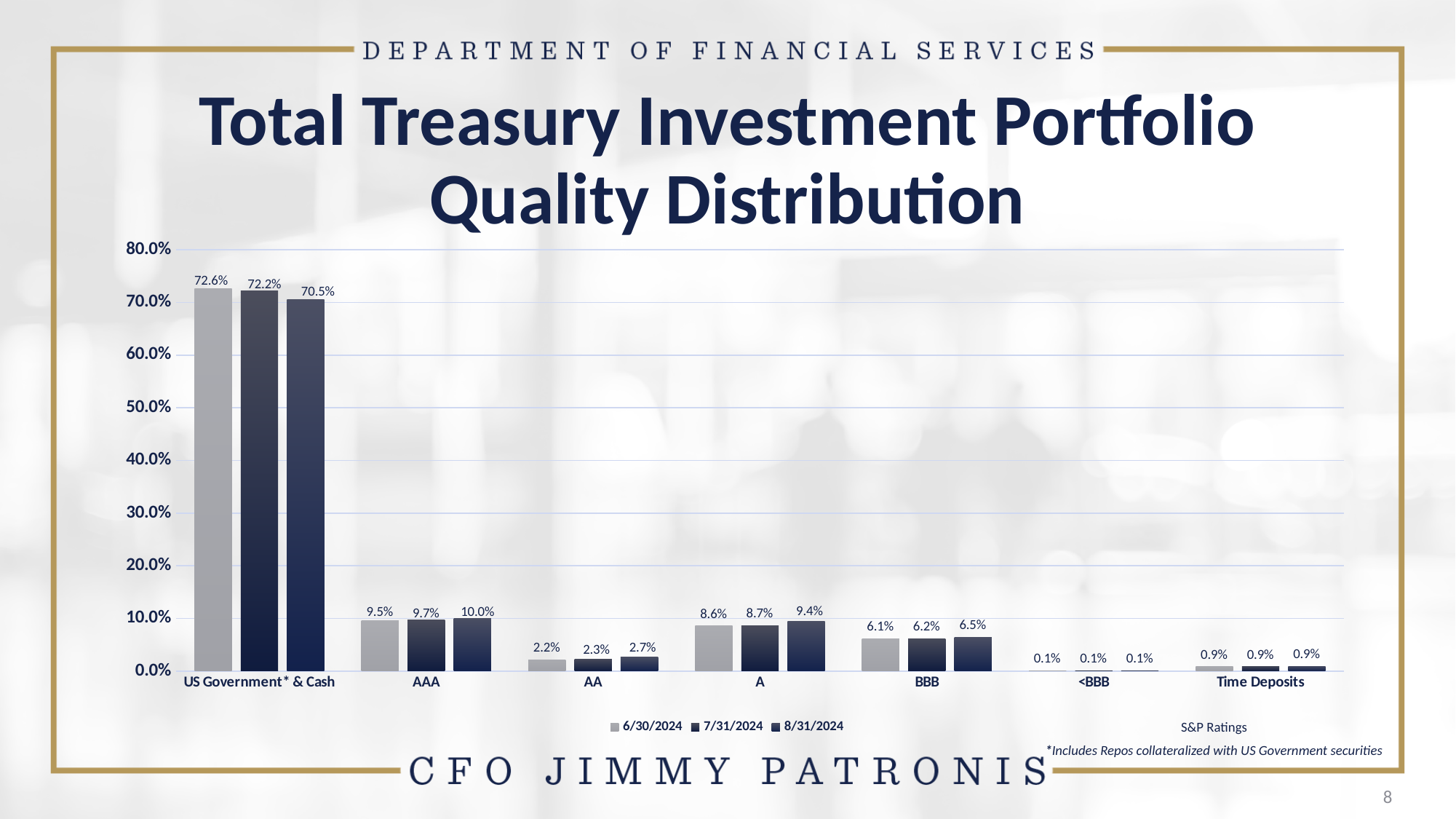
Does the value for AA rise or fall across the three dates from 6/30/2024 to 8/31/2024? Rise Which category has the lowest value in the 6/30/2024 series? <BBB Which is larger for the 8/31/2024 series: the value for A or the value for BBB? A How many series does the legend list? 3 Which category has the highest value in the 8/31/2024 series? US Government* & Cash What is the value for US Government* & Cash in the 6/30/2024 series? 72.6% What is the value for AAA in the 8/31/2024 series? 10.0% What is the title of the chart? Total Treasury Investment Portfolio Quality Distribution What is the difference between the 6/30/2024 and 8/31/2024 values for US Government* & Cash? 2.1% What is the value for BBB in the 7/31/2024 series? 6.2% What kind of chart is shown on the slide? Bar chart How many rating categories are shown on the x axis? 7